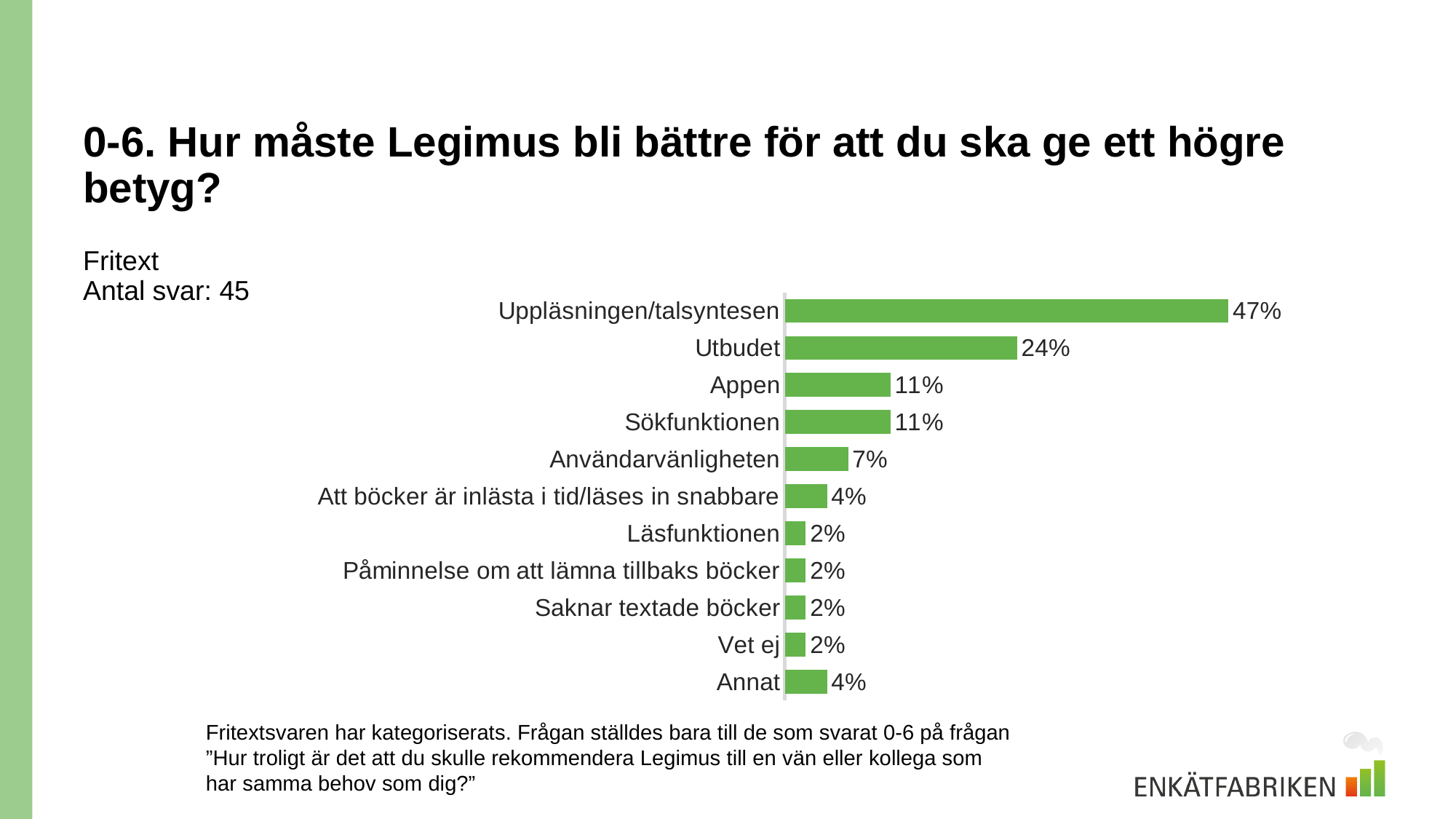
What is the value for Utbudet? 24% Which is larger, the value for Utbudet or the value for Sökfunktionen? Utbudet What is the difference between the values for Appen and Användarvänligheten? 4% Which category has the highest value? Uppläsningen/talsyntesen What is the difference between the values for Uppläsningen/talsyntesen and Utbudet? 23% What kind of chart is shown on the slide? Bar chart What is the value for Annat? 4% What is the value for Uppläsningen/talsyntesen? 47% What colour are the bars in the chart? Green How many categories are shown in the chart? 11 What is the value for Användarvänligheten? 7% How many categories have a value of 2%? 4